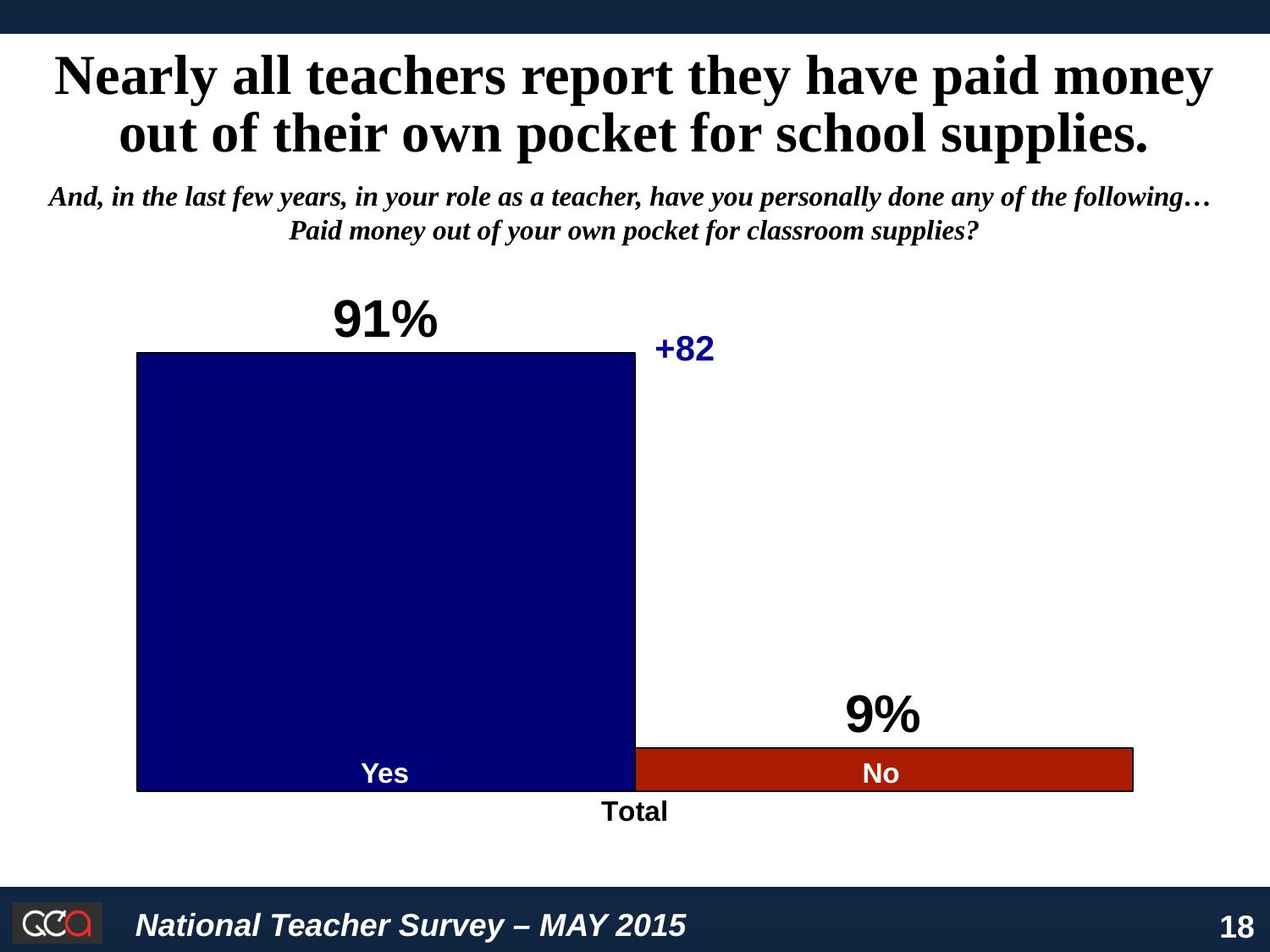
What label appears beneath the bars on the x axis? Total Which response has the lower value? No Is the value for Yes larger than the value for No? Yes What is the total of the Yes and No percentages? 100% What is the difference between the Yes and No percentages? 82% How many response categories are shown in the chart? 2 What percentage of teachers answered No? 9% What percentage of teachers answered Yes? 91% Which response has the higher value, Yes or No? Yes What kind of chart is shown on the slide? Bar chart What is the net figure printed next to the Yes bar? +82 What colour is the No bar? Red